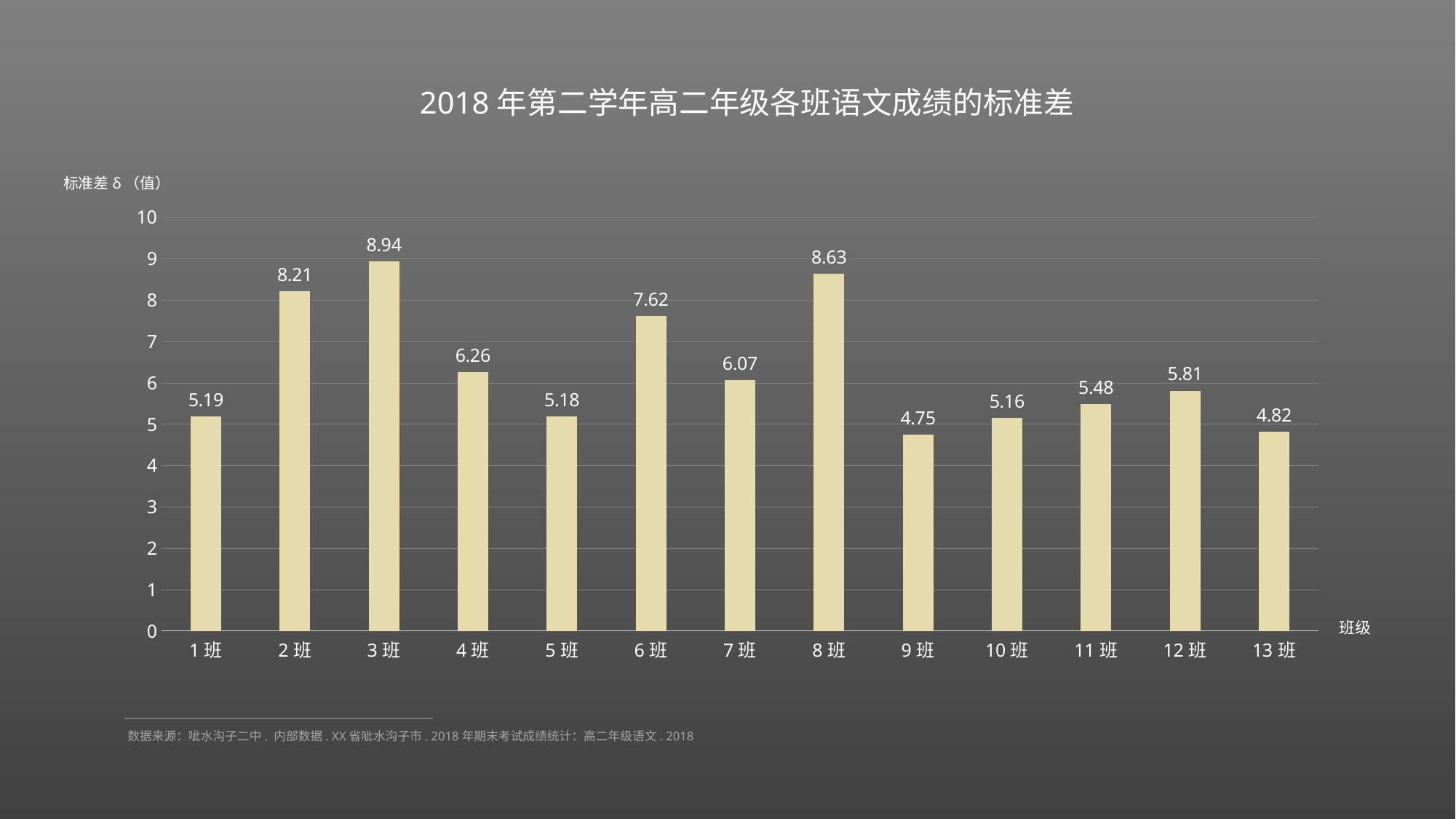
What is the standard deviation value for 3 班? 8.94 What is the standard deviation value for 9 班? 4.75 What is the title of the chart? 2018 年第二学年高二年级各班语文成绩的标准差 Which class has the lowest standard deviation? 9 班 What is the difference between the standard deviation of 3 班 and 8 班? 0.31 Which class has the highest standard deviation? 3 班 Which has a larger standard deviation, 4 班 or 7 班? 4 班 Is the value for 6 班 greater or less than 7? greater What kind of chart is shown on the slide? Bar chart What is the difference between the standard deviation of 2 班 and 13 班? 3.39 What is the standard deviation value for 12 班? 5.81 How many classes are shown on the x axis? 13